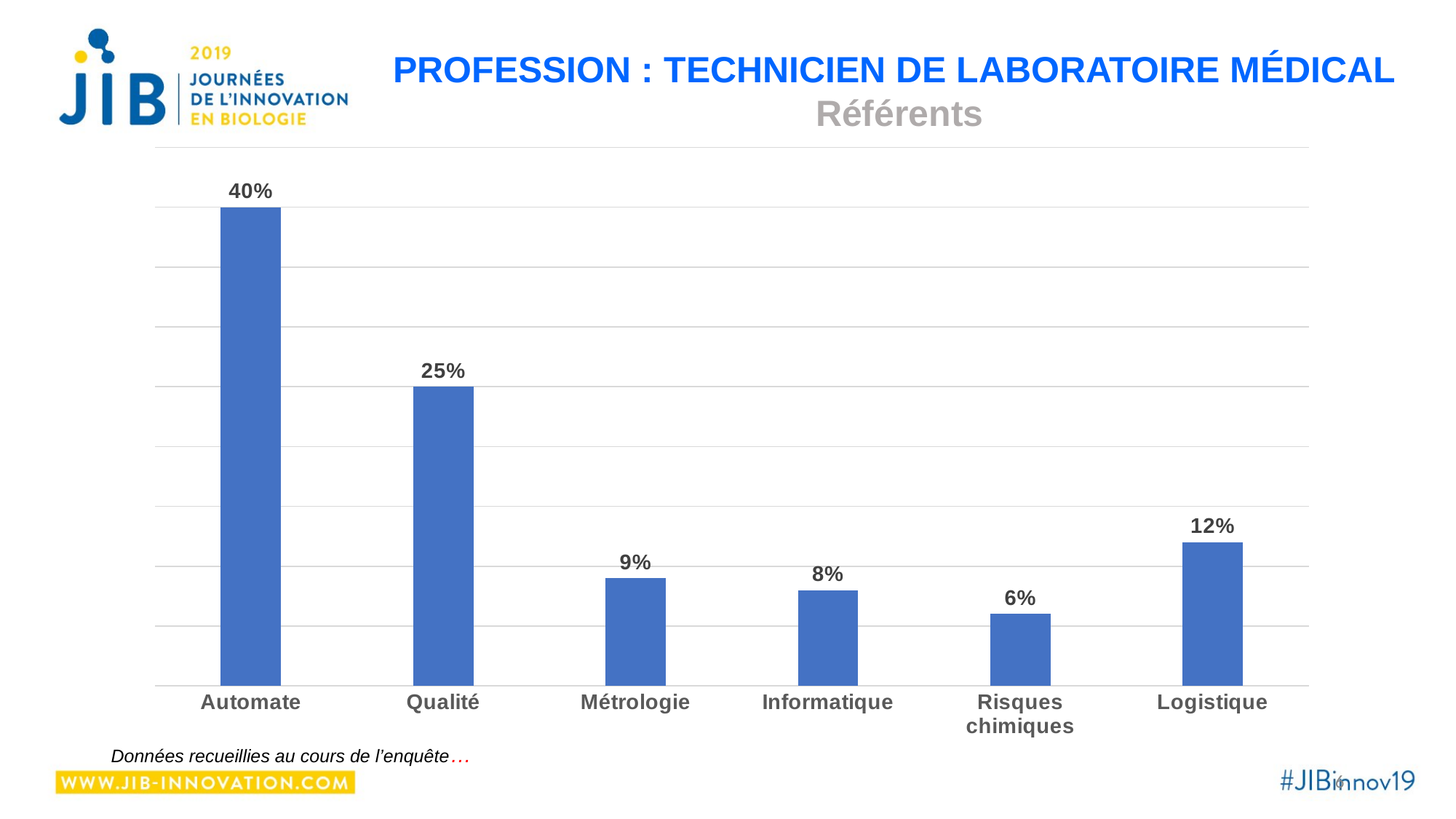
Which category has the highest value? Automate What is the value for Automate? 40% What is the value for Logistique? 12% What is the subtitle of the chart shown below the main title? Référents Which is larger, the value for Logistique or the value for Informatique? Logistique Which category has the lowest value? Risques chimiques What is the value for Métrologie? 9% How many categories are shown on the x axis? 6 What is the value for Risques chimiques? 6% What kind of chart is shown on the slide? Bar chart What is the value for Qualité? 25% What is the difference between the values for Automate and Qualité? 15%